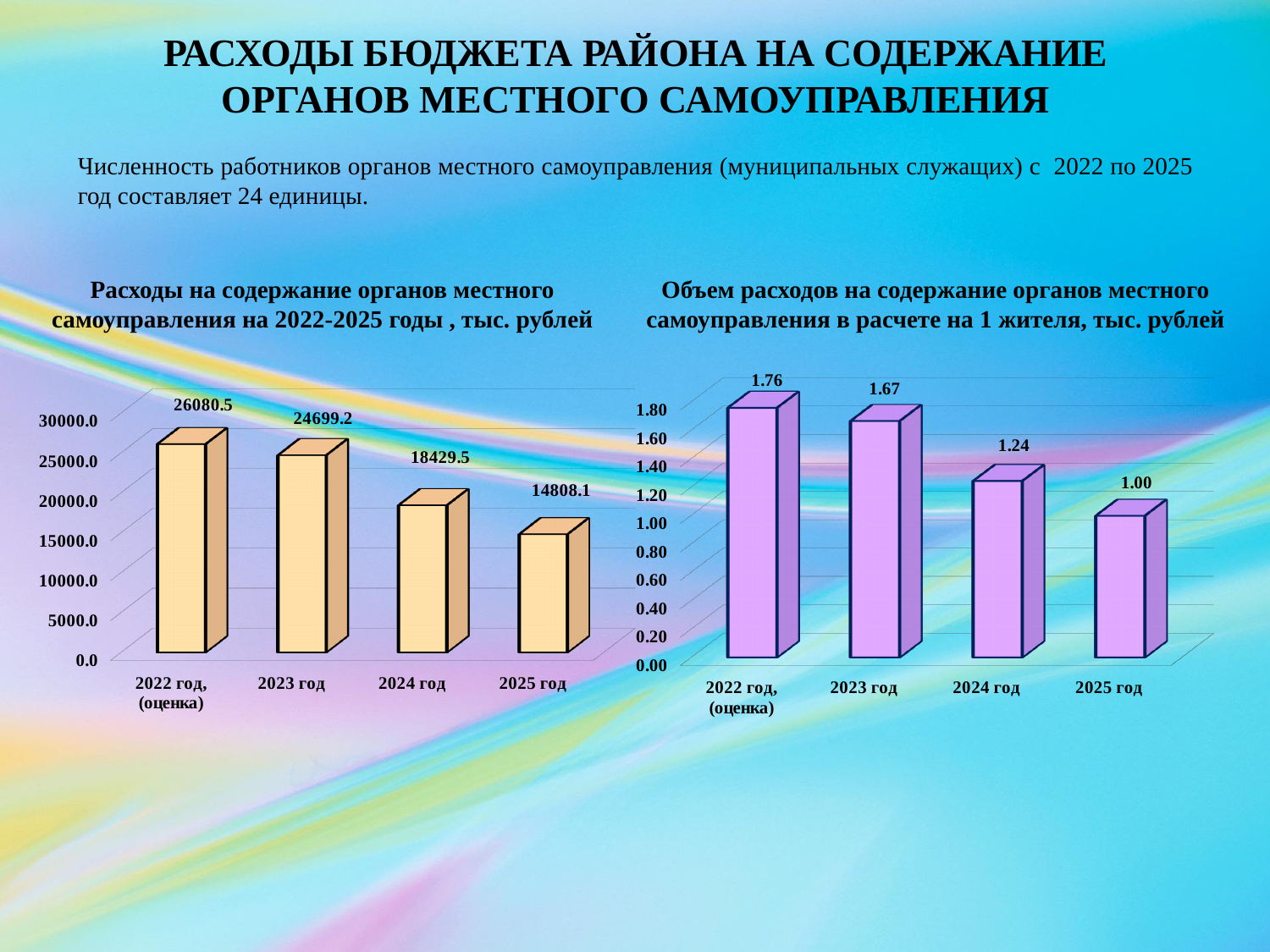
In the right chart (Объем расходов на содержание органов местного самоуправления в расчете на 1 жителя), what is the value for 2022 год (оценка)? 1.76 In the right chart (Объем расходов на содержание органов местного самоуправления в расчете на 1 жителя), what is the difference between the values for 2023 год and 2024 год? 0.43 In the left chart (Расходы на содержание органов местного самоуправления на 2022-2025 годы), what is the value for 2025 год? 14808.1 In the left chart (Расходы на содержание органов местного самоуправления на 2022-2025 годы), which year has the highest value? 2022 год, (оценка) In the left chart (Расходы на содержание органов местного самоуправления на 2022-2025 годы), what is the value for 2023 год? 24699.2 In the right chart (Объем расходов на содержание органов местного самоуправления в расчете на 1 жителя), which year has the lowest value? 2025 год In the right chart (Объем расходов на содержание органов местного самоуправления в расчете на 1 жителя), what is the value for 2024 год? 1.24 In the left chart (Расходы на содержание органов местного самоуправления на 2022-2025 годы), do the values rise or fall from 2022 to 2025? fall In the right chart (Объем расходов на содержание органов местного самоуправления в расчете на 1 жителя), which is larger: the value for 2023 год or 2025 год? 2023 год In the left chart (Расходы на содержание органов местного самоуправления на 2022-2025 годы), what is the difference between the values for 2022 год (оценка) and 2023 год? 1381.3 In the left chart (Расходы на содержание органов местного самоуправления на 2022-2025 годы), how many years are shown? 4 What type of chart is the right chart (Объем расходов на содержание органов местного самоуправления в расчете на 1 жителя)? bar chart